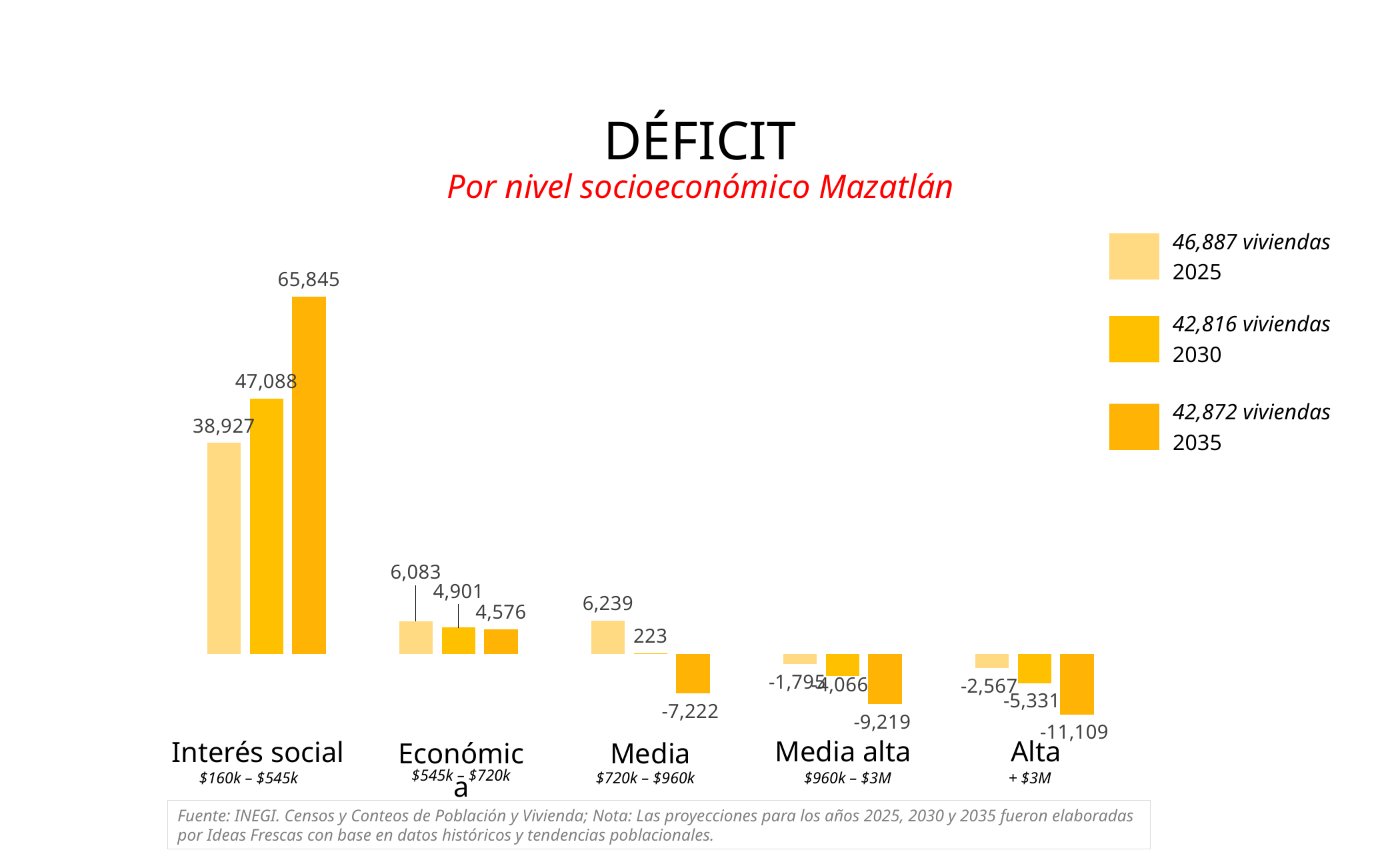
What is the difference between the 2035 and 2025 values for Interés social? 26,918 What is the 2035 value for Interés social? 65,845 How many series does the legend list? 3 What is the 2030 value for Alta? -5,331 How many categories are shown on the x axis? 5 Do the values for Alta rise or fall from 2025 to 2035? Fall Which category has the lowest 2035 value? Alta Which category has the highest 2025 value? Interés social Which is larger, the 2025 value for Económica or the 2025 value for Media? Media What is the 2025 value for Media? 6,239 What kind of chart is shown? Bar chart What is the 2035 value for Media alta? -9,219